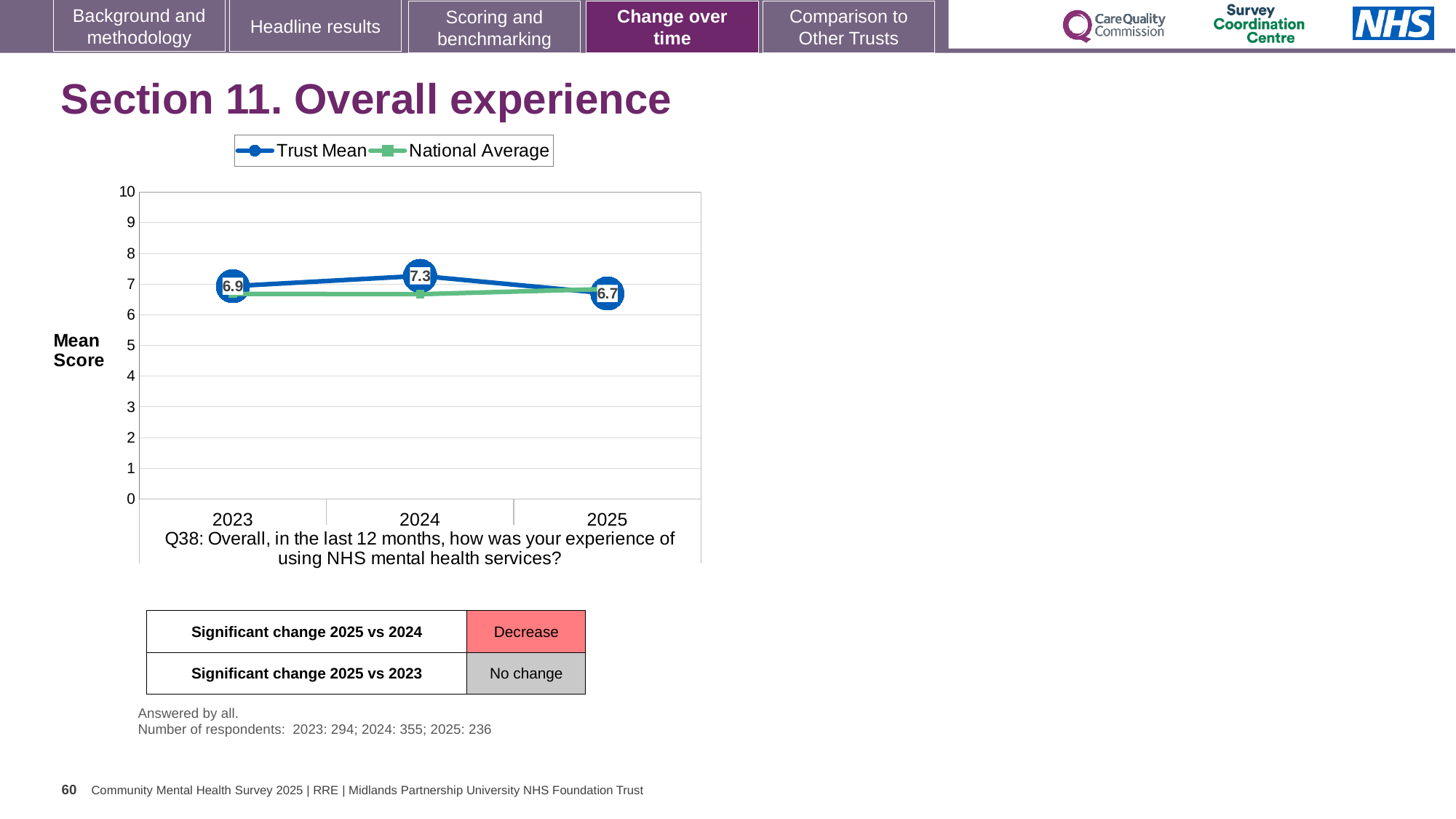
What is the Trust Mean score for 2024? 7.3 In which year is the Trust Mean lowest? 2025 What is the difference between the Trust Mean in 2024 and in 2025? 0.6 Which is larger, the Trust Mean in 2023 or in 2025? 2023 How many years are plotted on the x axis? 3 What is the difference between the Trust Mean in 2024 and in 2023? 0.4 What kind of chart is shown on the slide? Line chart What is the Trust Mean score for 2025? 6.7 How many series does the legend list? 2 What is the Trust Mean score for 2023? 6.9 Is the National Average value for 2023 greater or less than 5? greater In which year is the Trust Mean highest? 2024